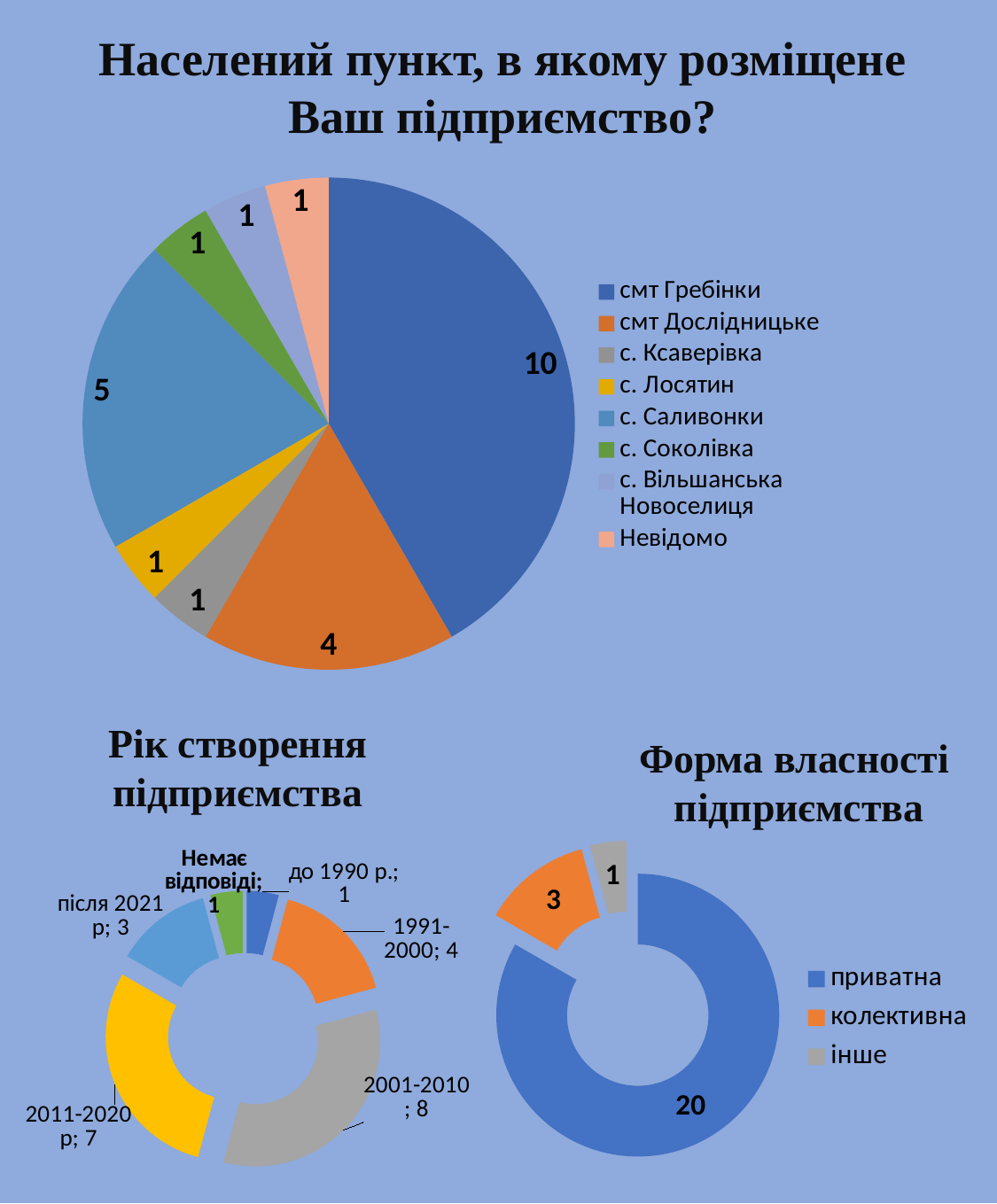
In the chart titled "Населений пункт, в якому розміщене Ваш підприємство?", which category has the highest value? смт Гребінки In the chart titled "Рік створення підприємства", which category has the highest value? 2001-2010 In the chart titled "Рік створення підприємства", what is the value for 2001-2010? 8 In the chart titled "Населений пункт, в якому розміщене Ваш підприємство?", what is the value for с. Саливонки? 5 In the chart titled "Форма власності підприємства", what share of the total does приватна represent? 20 of 24 (83.3%) How many categories does the legend of the chart titled "Населений пункт, в якому розміщене Ваш підприємство?" list? 8 What kind of chart is the chart titled "Населений пункт, в якому розміщене Ваш підприємство?"? Pie chart In the chart titled "Населений пункт, в якому розміщене Ваш підприємство?", what is the difference between смт Гребінки and смт Дослідницьке? 6 In the chart titled "Форма власності підприємства", what is the value for колективна? 3 In the chart titled "Населений пункт, в якому розміщене Ваш підприємство?", what is the value for смт Гребінки? 10 In the chart titled "Форма власності підприємства", which category has the lowest value? інше In the chart titled "Рік створення підприємства", which is larger: 2011-2020 р or 1991-2000? 2011-2020 р